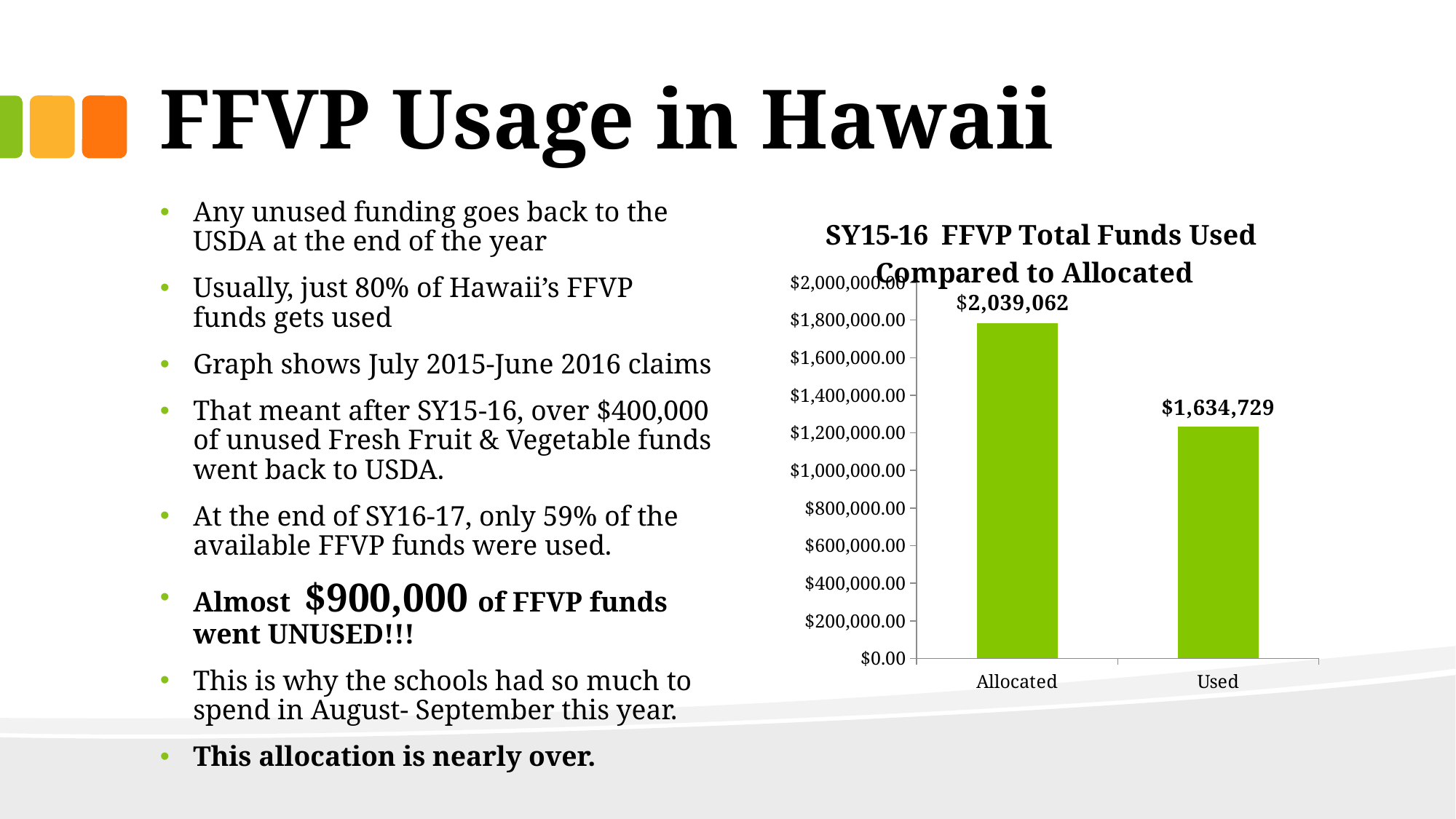
What is the value of the Allocated bar in the chart? $2,039,062 What colour are the bars in the chart? Green Which category has the lowest value in the chart? Used Is the value for Used greater or less than $1,000,000.00? greater What is the difference between the Allocated and Used values in the chart? $404,333 How many bars are plotted in the chart? 2 What is the value of the Used bar in the chart? $1,634,729 Which category has the higher value in the chart, Allocated or Used? Allocated What is the title of the chart on the slide? SY15-16 FFVP Total Funds Used Compared to Allocated Is the value for Allocated greater or less than $1,600,000.00? greater What kind of chart is shown on the slide? Bar chart Which category has the highest value in the chart? Allocated